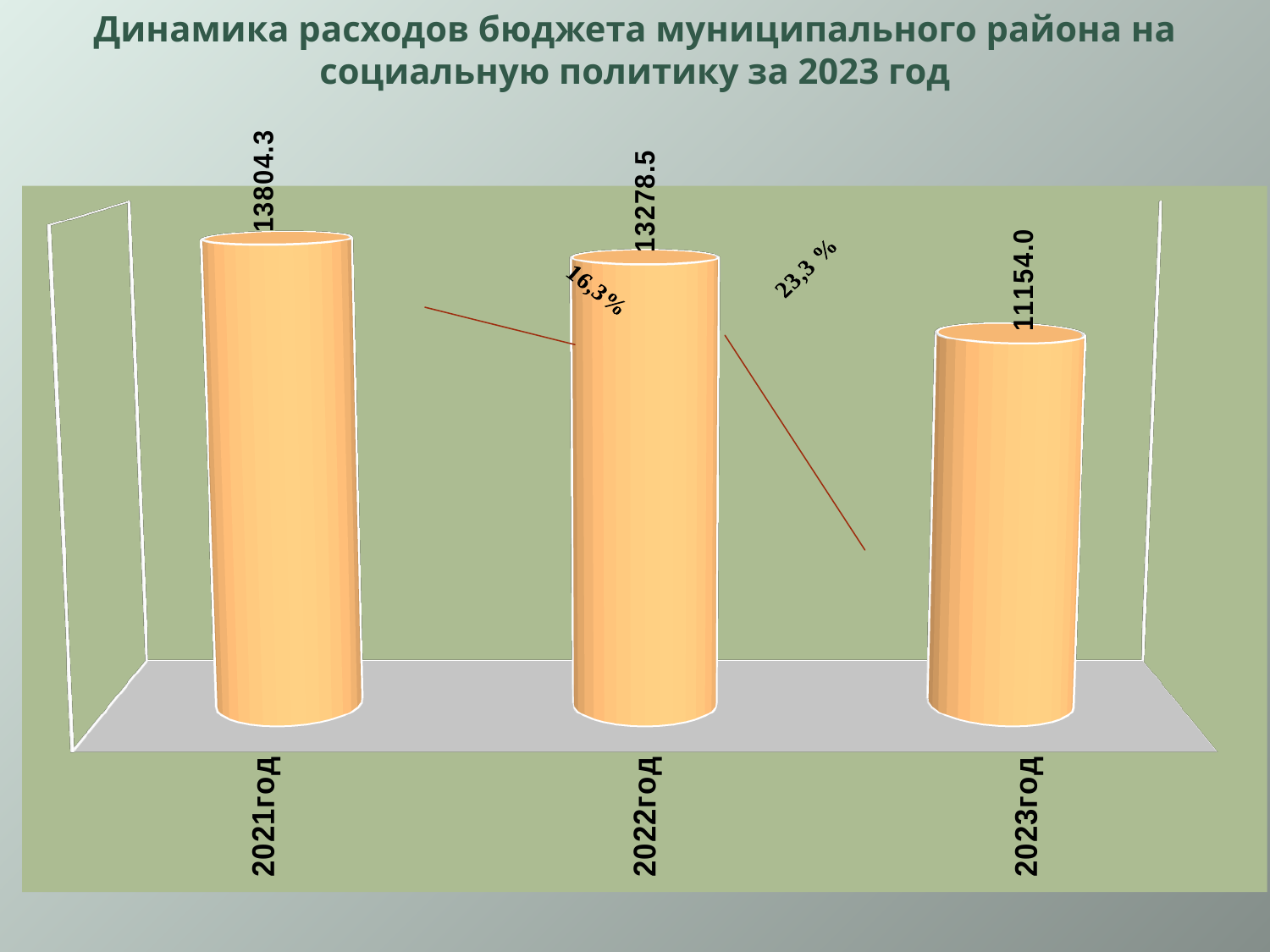
What is the difference between the values for 2022год and 2023год? 2124.5 Which year has the highest value? 2021год What is the difference between the values for 2021год and 2022год? 525.8 What is the value shown for 2021год? 13804.3 How many years are shown on the chart? 3 Do the values rise or fall from 2021год to 2023год? Fall What kind of chart is shown on the slide? Bar chart What is the value shown for 2023год? 11154.0 What is the value shown for 2022год? 13278.5 What is the difference between the values for 2021год and 2023год? 2650.3 Which is larger, the value for 2022год or the value for 2023год? 2022год Which year has the lowest value? 2023год